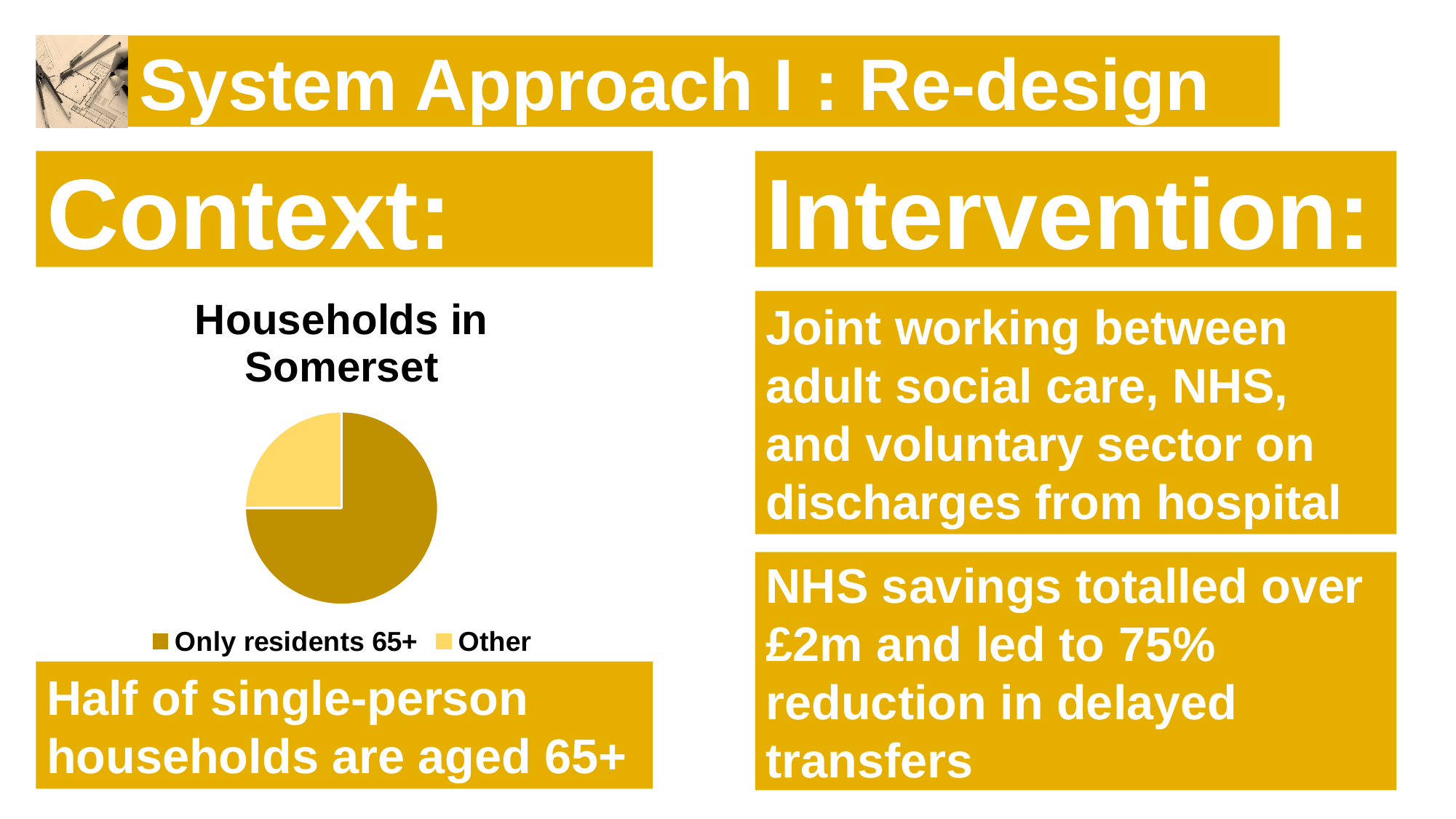
How many entries does the legend of the Households in Somerset pie chart list? 2 What kind of chart is shown under the Context heading? Pie chart Which slice of the Households in Somerset pie chart is the smallest? Other In the Households in Somerset pie chart, which is larger: the Only residents 65+ slice or the Other slice? Only residents 65+ How many slices does the Households in Somerset pie chart have? 2 What colour is the Other slice in the Households in Somerset pie chart? Light yellow What is the title of the pie chart? Households in Somerset Which slice of the Households in Somerset pie chart is the largest? Only residents 65+